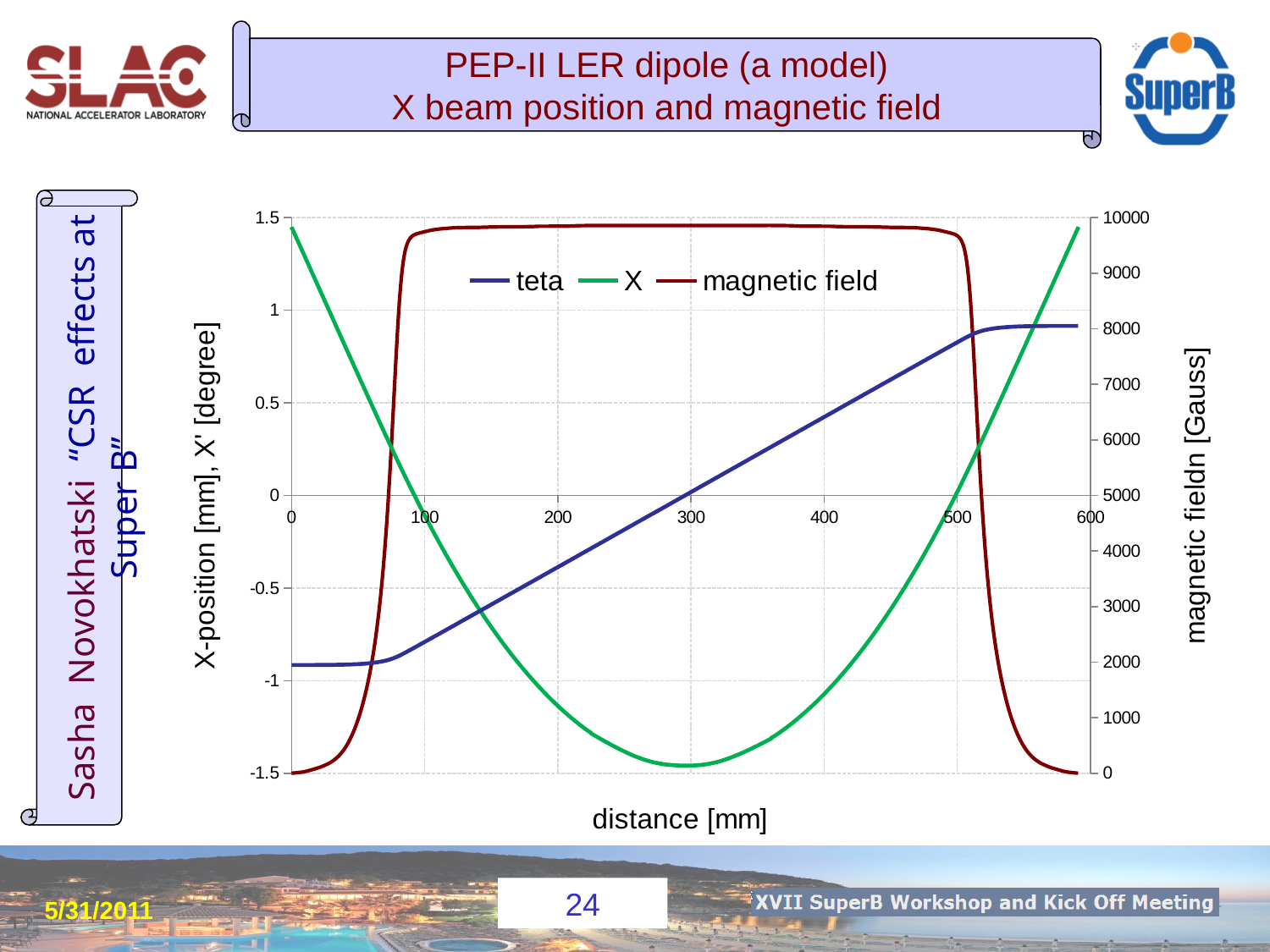
Does the teta series rise or fall as distance increases from 0 to 600 mm? rise Which is larger at a distance of 100 mm, the teta value or the X value? X What kind of chart is shown on the slide? line chart How many series does the legend list? 3 Is the teta value at a distance of 0 mm greater or less than -0.5? less Which is larger, the X value at a distance of 0 mm or the X value at a distance of 300 mm? X at 0 mm Is the magnetic field value at a distance of 300 mm greater or less than 9000 Gauss? greater Is the teta value at a distance of 600 mm greater or less than 0.5? greater What is the label of the horizontal axis? distance [mm] What are the three series named in the legend? teta, X, magnetic field